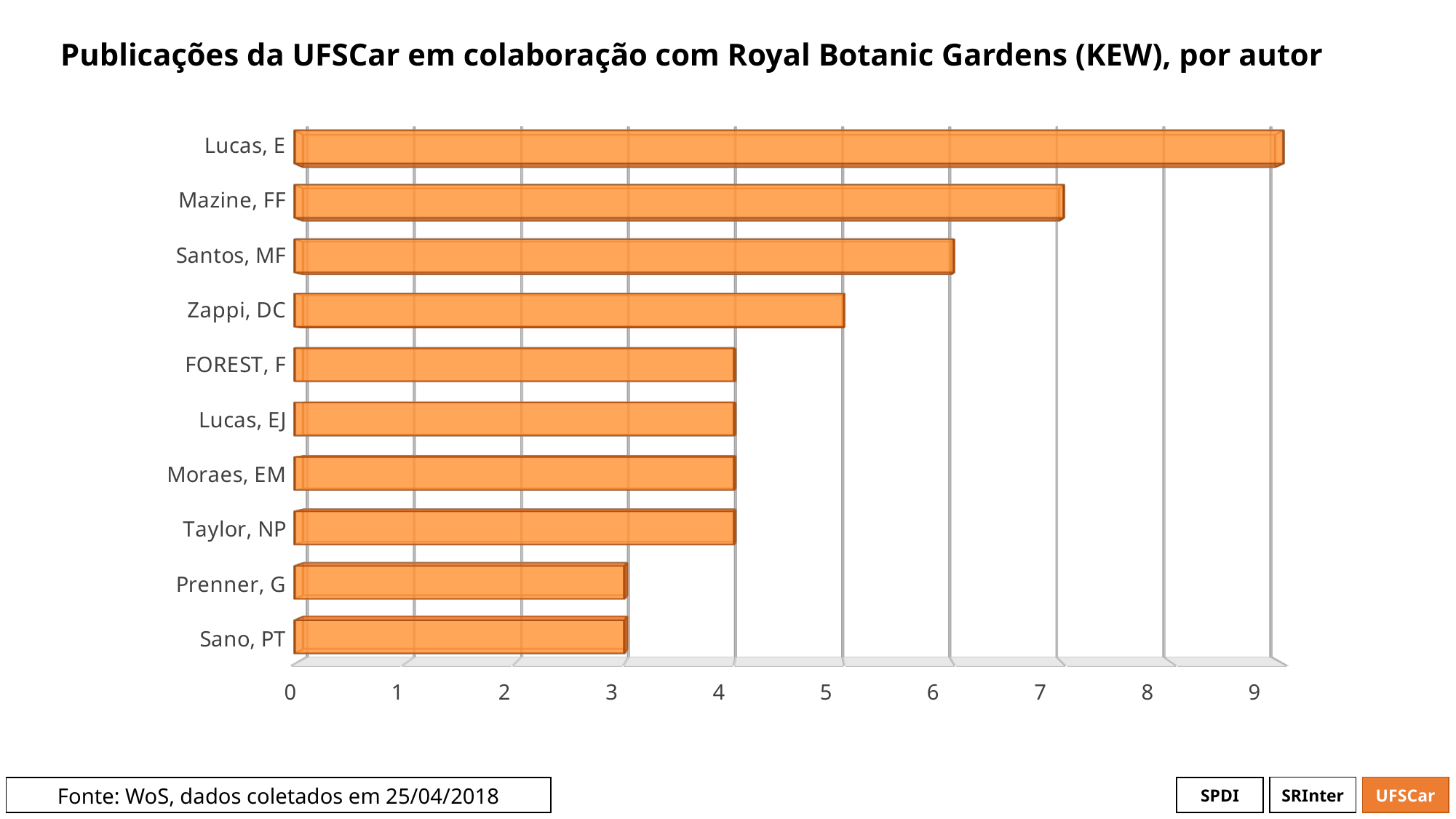
Which author has the highest number of publications? Lucas, E How many authors are shown in the chart? 10 What is the title of the chart? Publicações da UFSCar em colaboração com Royal Botanic Gardens (KEW), por autor Is the value for Mazine, FF greater or less than 6? greater Is the value for Zappi, DC greater or less than 4? greater Which is larger, the value for Mazine, FF or the value for Zappi, DC? Mazine, FF Which author has the longest bar in the chart? Lucas, E Which is larger, the value for Santos, MF or the value for Taylor, NP? Santos, MF Is the value for Lucas, E greater or less than 8? greater What kind of chart is shown on the slide? bar chart